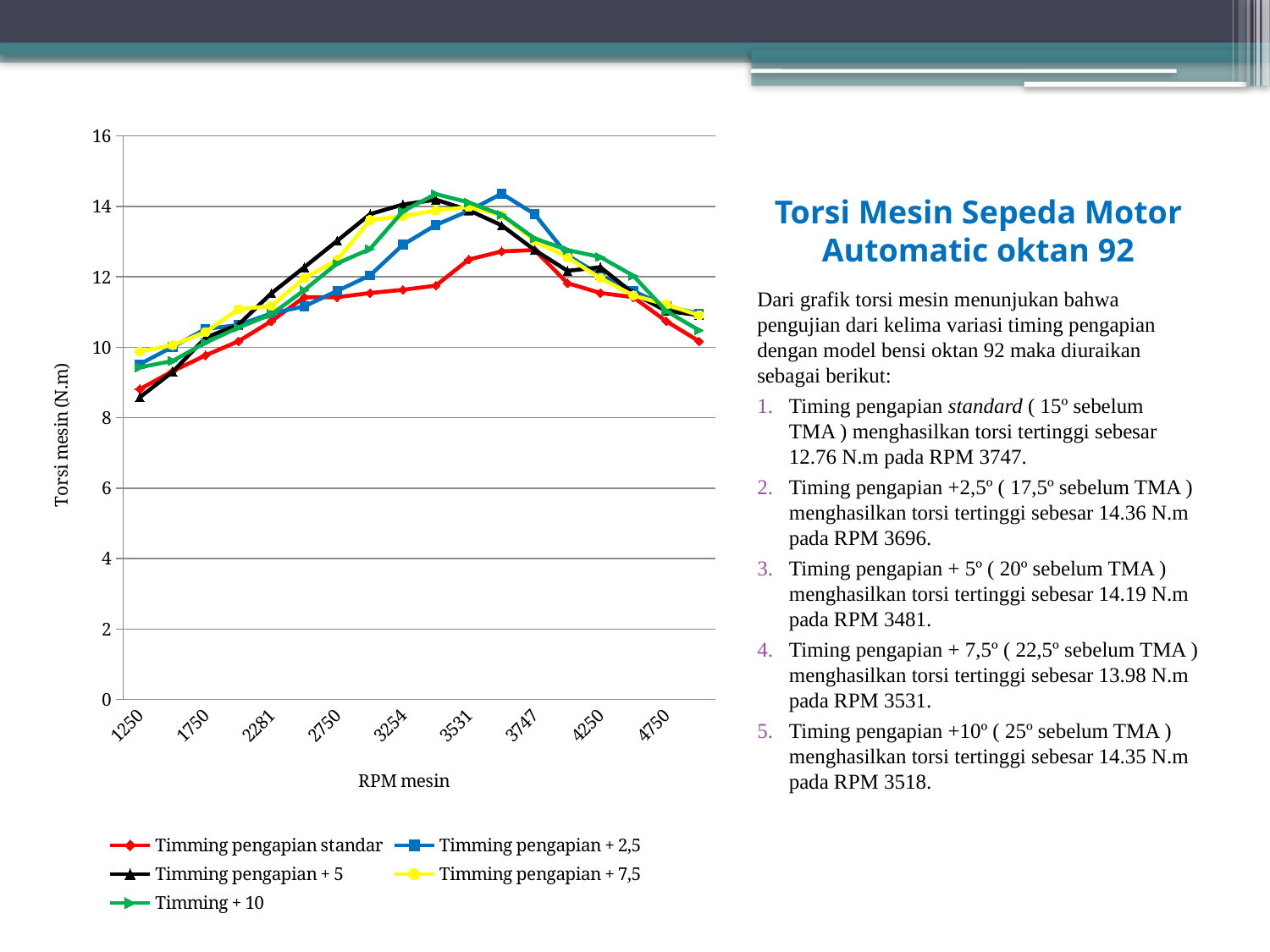
Is the value for Timming pengapian + 5 at 3254 RPM greater or less than 12? greater Which series reaches the lowest peak value on the chart? Timming pengapian standar Is the value for Timming pengapian + 7,5 at 1250 RPM greater or less than 8? greater Does the Timming pengapian standar series rise or fall between 1250 RPM and 3747 RPM? rise At 1250 RPM, which series has the higher value: Timming pengapian + 7,5 or Timming pengapian standar? Timming pengapian + 7,5 At 3747 RPM, which series has the higher value: Timming pengapian + 2,5 or Timming pengapian standar? Timming pengapian + 2,5 Is the value for Timming pengapian + 2,5 at 3747 RPM greater or less than 12? greater What kind of chart is shown on the slide? line chart How many series does the chart legend list? 5 What is the label of the chart's vertical axis? Torsi mesin (N.m) What is the label of the chart's horizontal axis? RPM mesin